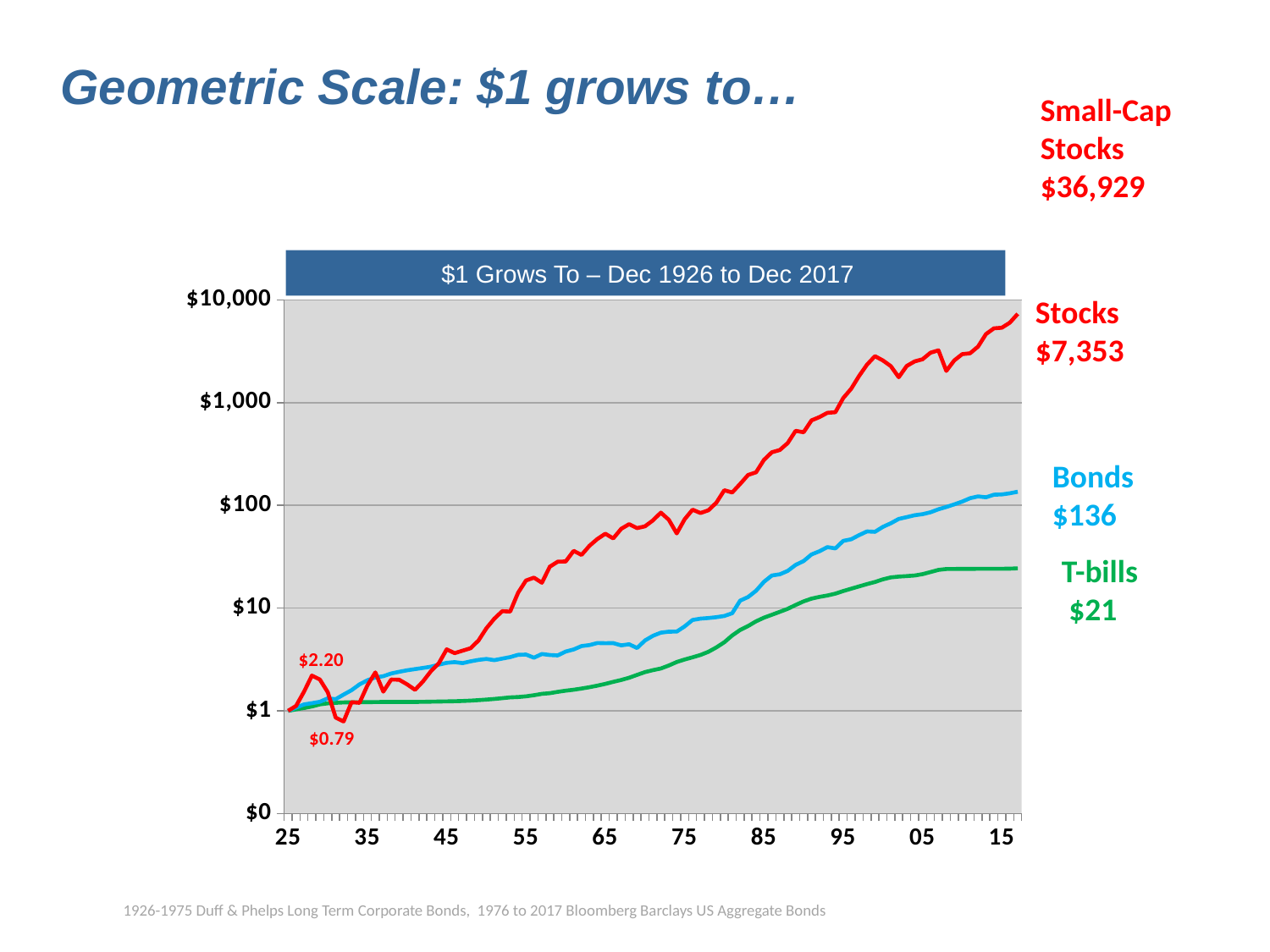
Is the value of the Stocks line around 1965 greater or less than $10? greater What is the difference between the ending values of Bonds and T-bills? $115 Which has a larger ending value, Bonds or T-bills? Bonds What does $1 in Stocks grow to by the end of the chart? $7,353 How many lines are plotted on the chart? 3 What kind of chart is shown on the slide? line chart Which plotted series has the highest ending value? Stocks What is the title shown on the chart? $1 Grows To – Dec 1926 to Dec 2017 Which plotted series has the lowest ending value? T-bills What is the lowest labeled value on the Stocks line in the early years? $0.79 What does $1 in Bonds grow to by the end of the chart? $136 What does $1 in T-bills grow to by the end of the chart? $21